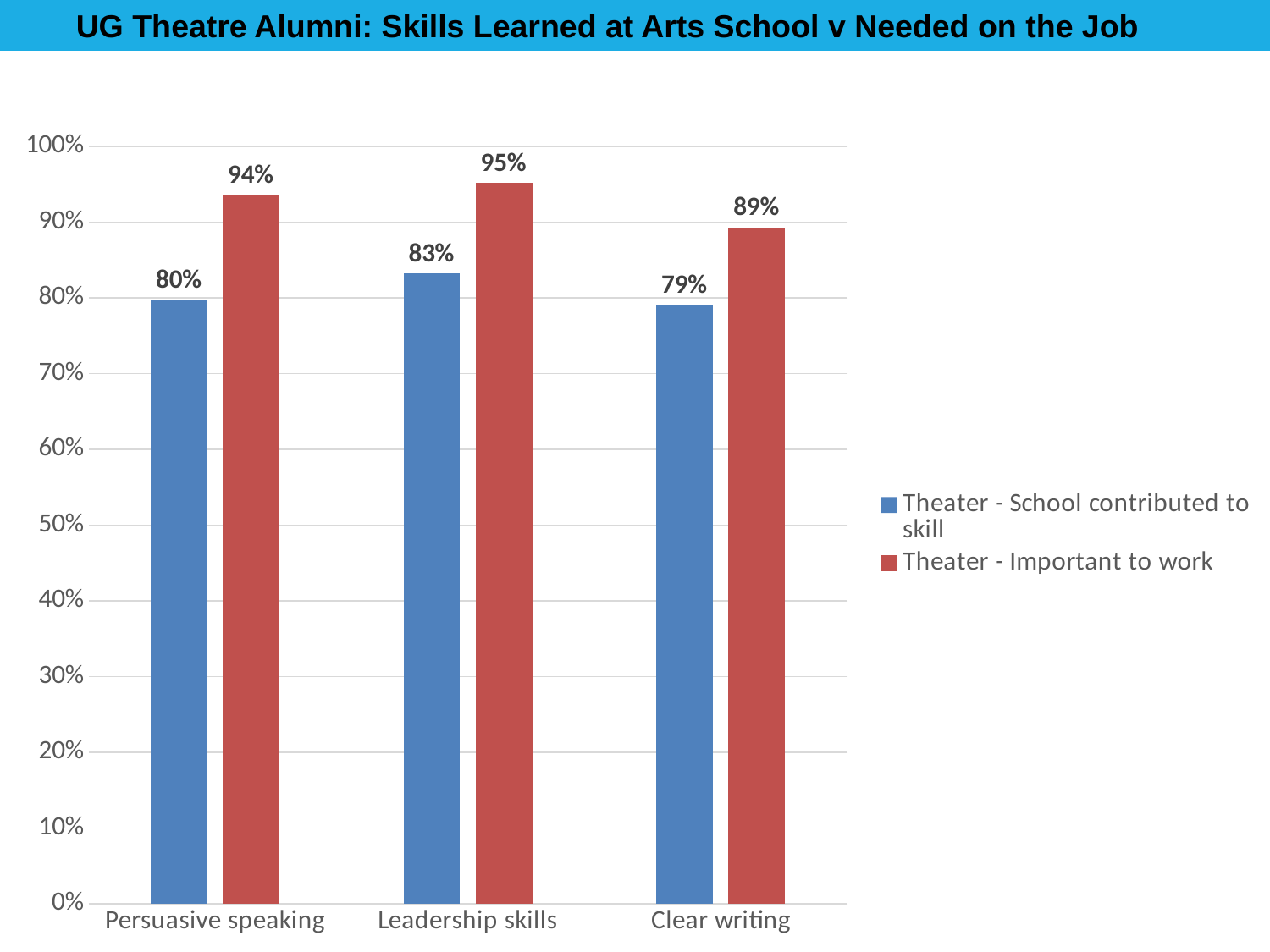
Which category has the highest value in the Theater - Important to work series? Leadership skills What is the value for Leadership skills in the Theater - Important to work series? 95% How many series does the legend list? 2 What is the value for Persuasive speaking in the Theater - School contributed to skill series? 80% Which category has the lowest value in the Theater - School contributed to skill series? Clear writing What is the difference between the Theater - Important to work and Theater - School contributed to skill values for Persuasive speaking? 14% What kind of chart is shown on the slide? Bar chart Which is larger for Clear writing: Theater - School contributed to skill or Theater - Important to work? Theater - Important to work What is the value for Persuasive speaking in the Theater - Important to work series? 94% What is the value for Clear writing in the Theater - School contributed to skill series? 79% How many categories are shown on the x axis? 3 What colour are the bars for the Theater - Important to work series? Red